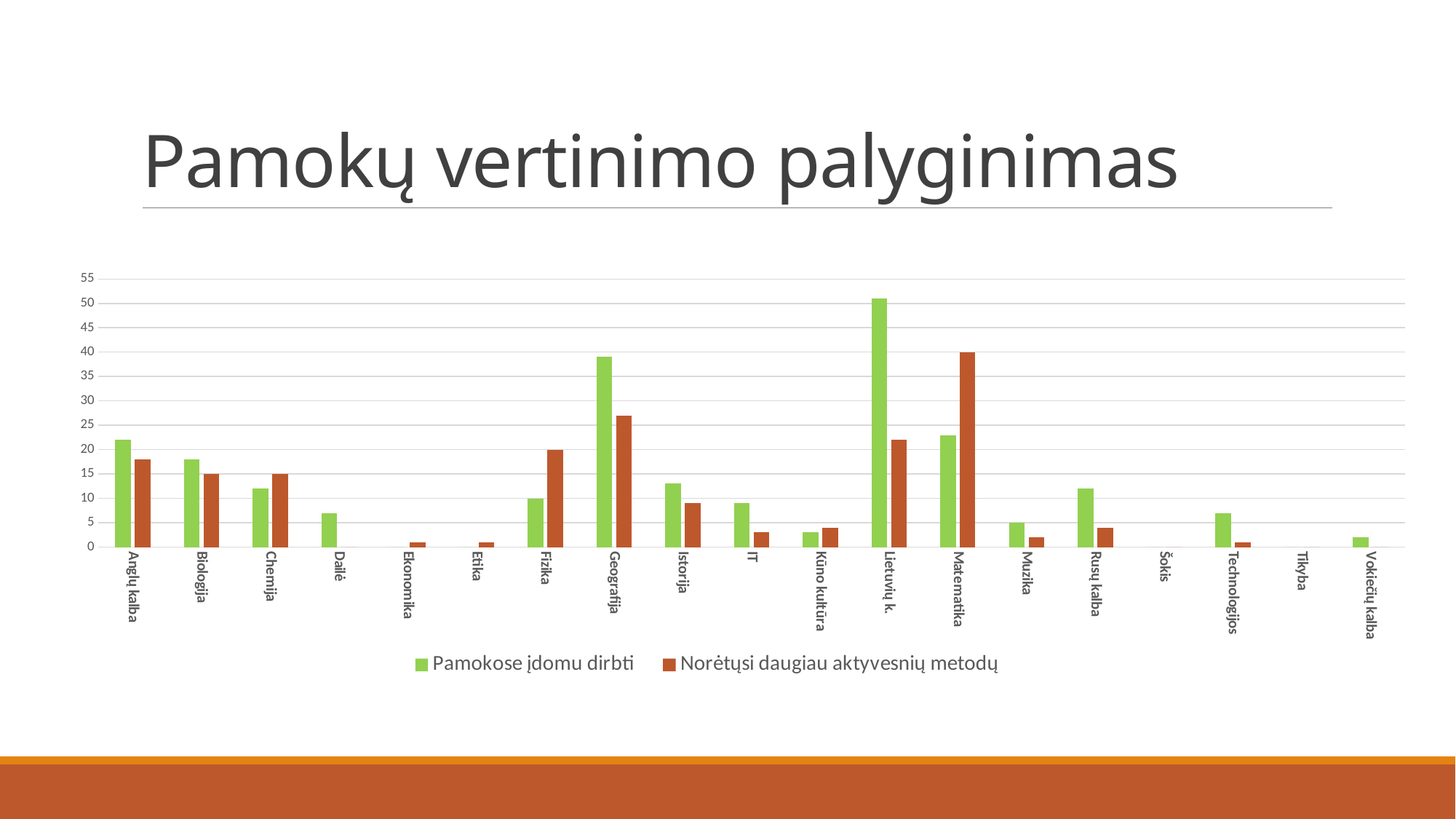
For Fizika, which series has the larger value: 'Pamokose įdomu dirbti' or 'Norėtųsi daugiau aktyvesnių metodų'? Norėtųsi daugiau aktyvesnių metodų What is the title of the slide containing the chart? Pamokų vertinimo palyginimas How many series does the legend list? 2 How many subject categories are shown on the x axis? 19 For Geografija, which series has the larger value: 'Pamokose įdomu dirbti' or 'Norėtųsi daugiau aktyvesnių metodų'? Pamokose įdomu dirbti What type of chart is shown on the slide? bar chart Is the value for 'Pamokose įdomu dirbti' for Geografija greater or less than 35? greater Which subject has the highest value for 'Norėtųsi daugiau aktyvesnių metodų'? Matematika What is the value for 'Norėtųsi daugiau aktyvesnių metodų' for Matematika? 40 What is the value for 'Norėtųsi daugiau aktyvesnių metodų' for Fizika? 20 Is the value for 'Pamokose įdomu dirbti' for Lietuvių k. greater or less than 45? greater Which subject has the highest value for 'Pamokose įdomu dirbti'? Lietuvių k.